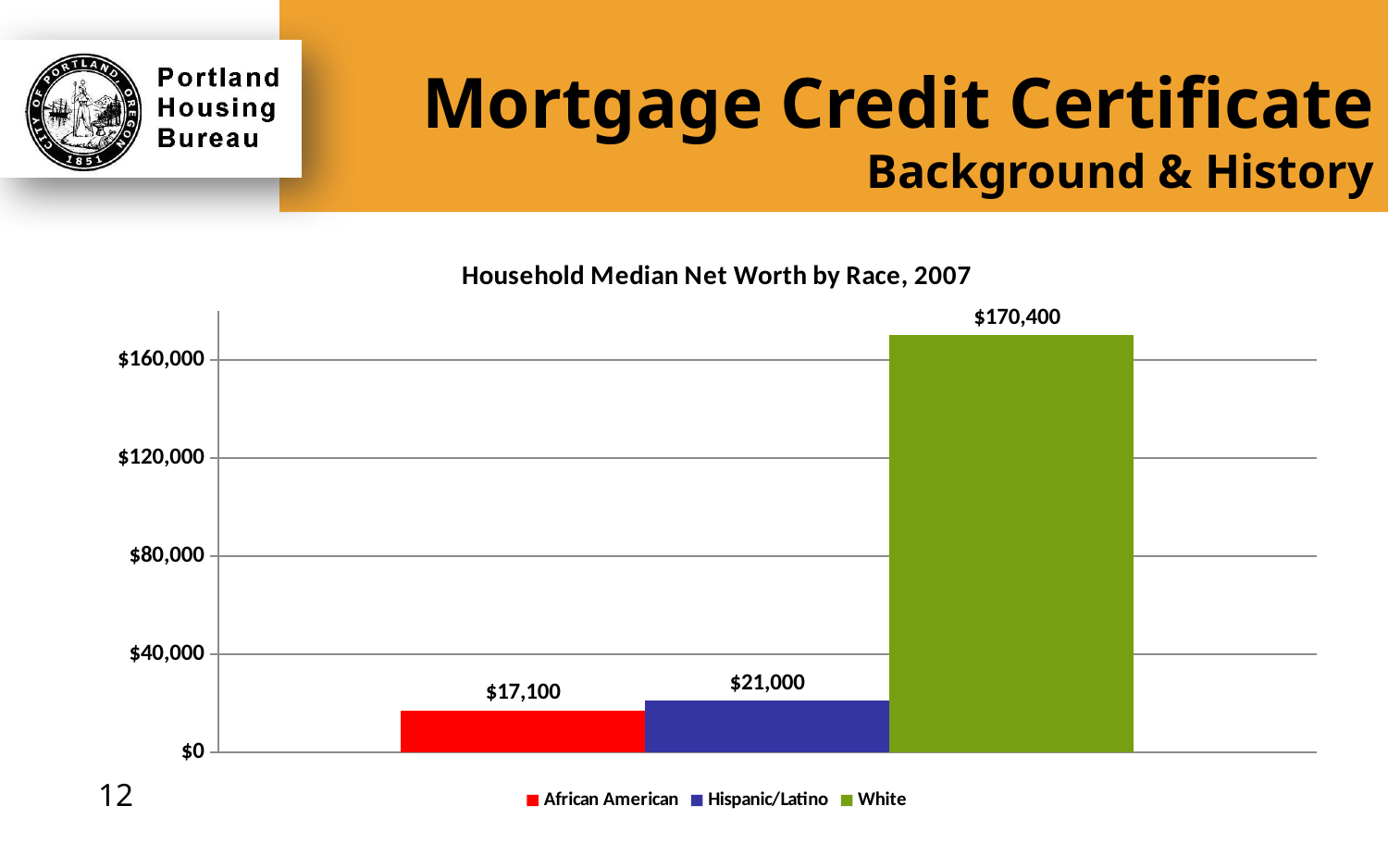
Which group has the lowest household median net worth? African American Which group has the highest household median net worth? White What is the difference between the median net worth of White and African American households? $153,300 How many groups are shown in the chart? 3 Is the value for White households greater or less than $160,000? greater What is the household median net worth for White households? $170,400 What is the difference between the median net worth of Hispanic/Latino and African American households? $3,900 What is the household median net worth for African American households? $17,100 Which is larger, the median net worth for Hispanic/Latino households or for African American households? Hispanic/Latino What is the title of the chart? Household Median Net Worth by Race, 2007 What type of chart is shown on the slide? Bar chart What is the household median net worth for Hispanic/Latino households? $21,000